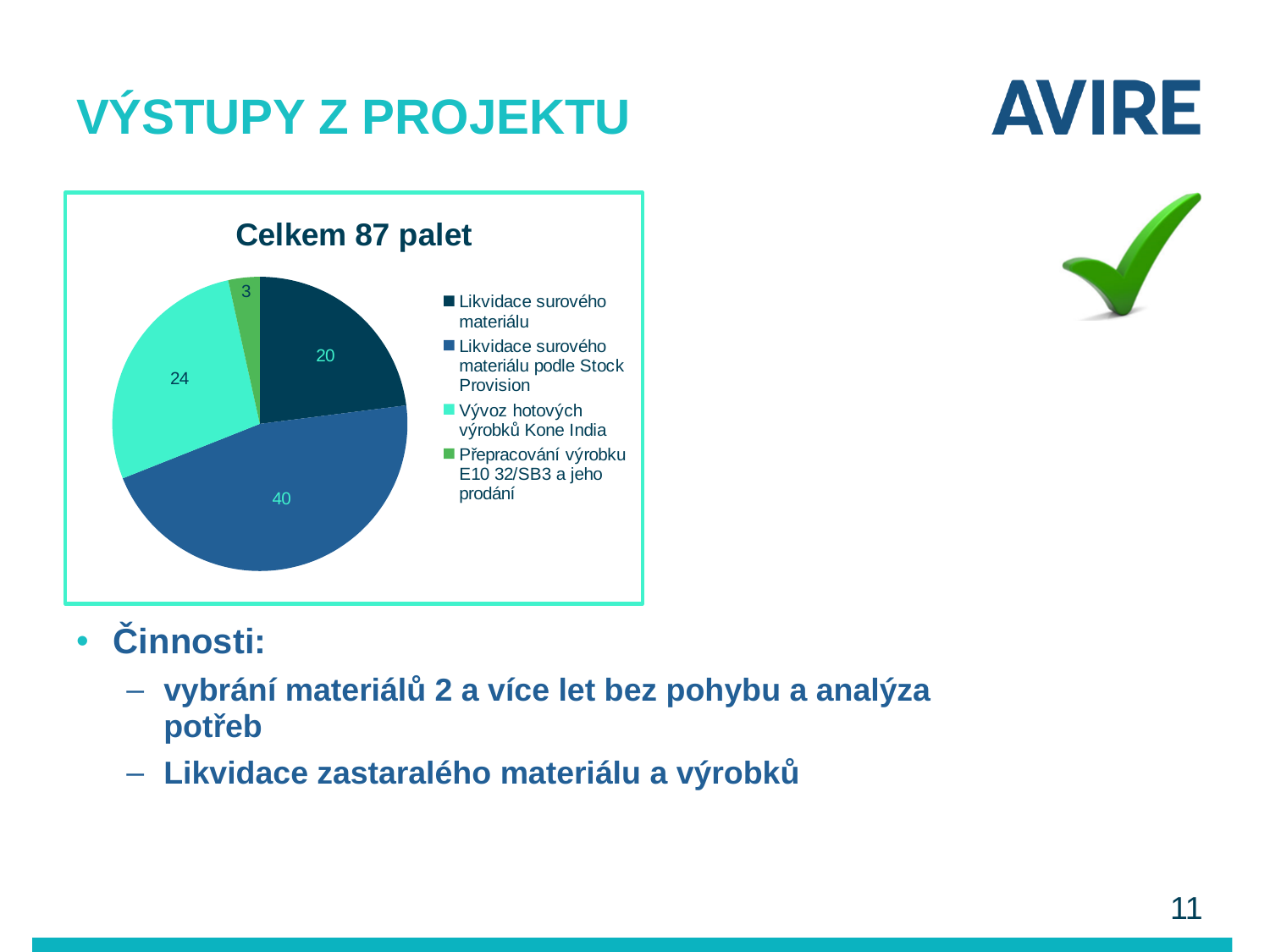
What is the value for 'Likvidace surového materiálu podle Stock Provision'? 40 What is the value for 'Vývoz hotových výrobků Kone India'? 24 What is the title of the pie chart? Celkem 87 palet How many slices does the pie chart have? 4 Which category has the largest slice of the pie? Likvidace surového materiálu podle Stock Provision What is the total of all slices in the pie chart? 87 How many entries does the legend of the pie chart list? 4 What type of chart is shown on the slide? Pie chart What is the value for 'Přepracování výrobku E10 32/SB3 a jeho prodání'? 3 Which is larger: the value for 'Vývoz hotových výrobků Kone India' or the value for 'Likvidace surového materiálu'? Vývoz hotových výrobků Kone India Which category has the smallest slice of the pie? Přepracování výrobku E10 32/SB3 a jeho prodání What is the difference between the values for 'Likvidace surového materiálu podle Stock Provision' and 'Likvidace surového materiálu'? 20